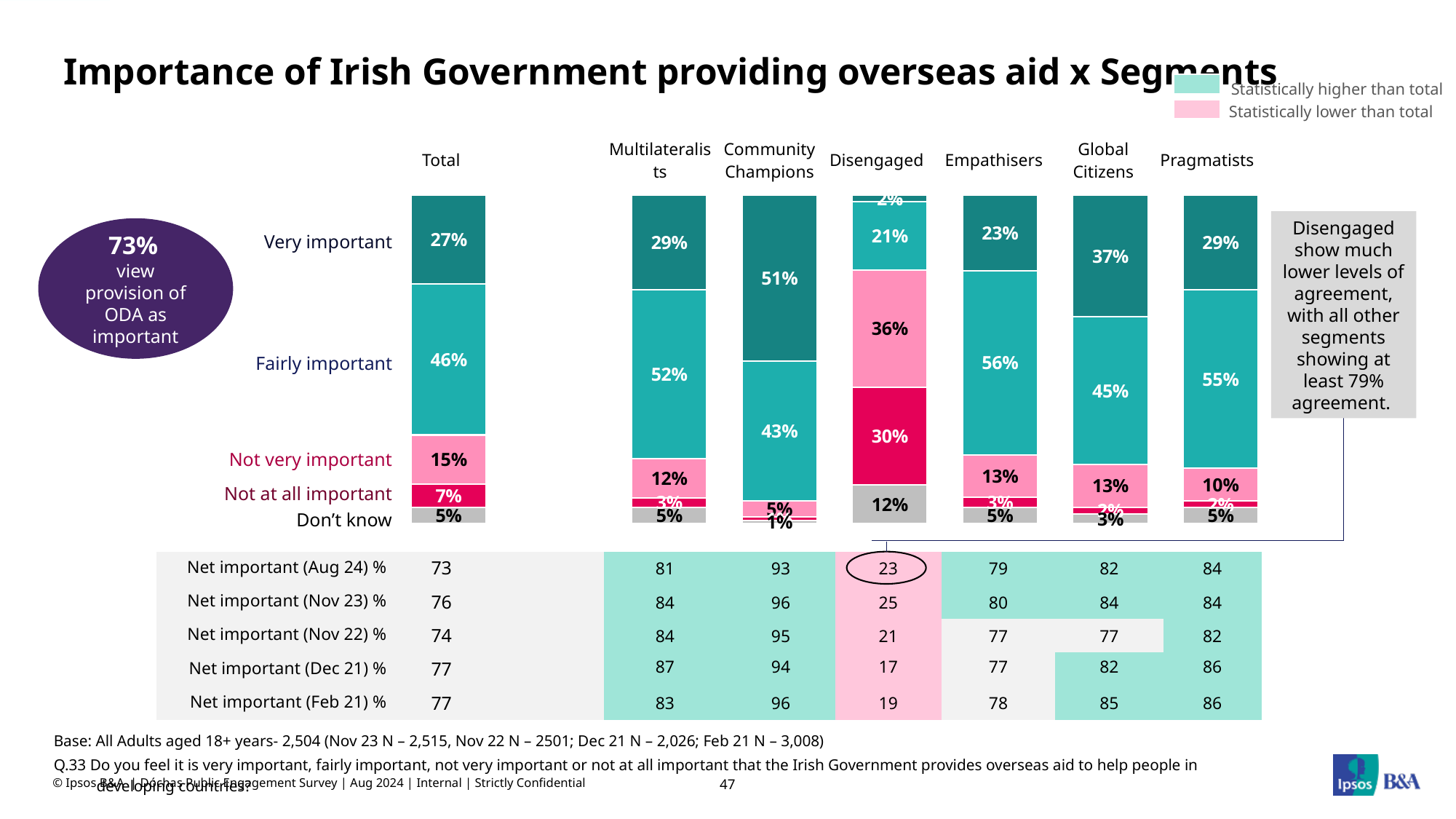
What is the difference between the Fairly important share for Empathisers and for the Total? 10 percentage points How many segments are shown in the chart, excluding Total? 6 What percentage of Global Citizens say providing overseas aid is Very important? 37% What is the Net important (Aug 24) % for the Disengaged segment? 23 What percentage of the Disengaged segment say providing overseas aid is Not at all important? 30% Which is larger: the Very important share for Multilateralists or for Empathisers? Multilateralists Which segment has the lowest share saying Fairly important? Disengaged What does the light pink shading in the legend indicate? Statistically lower than total Which segment has the highest share saying Very important? Community Champions What percentage of the Total say providing overseas aid is Very important? 27% What kind of chart is used to show the importance ratings? Stacked bar chart What is the Net important (Aug 24) % for Community Champions? 93